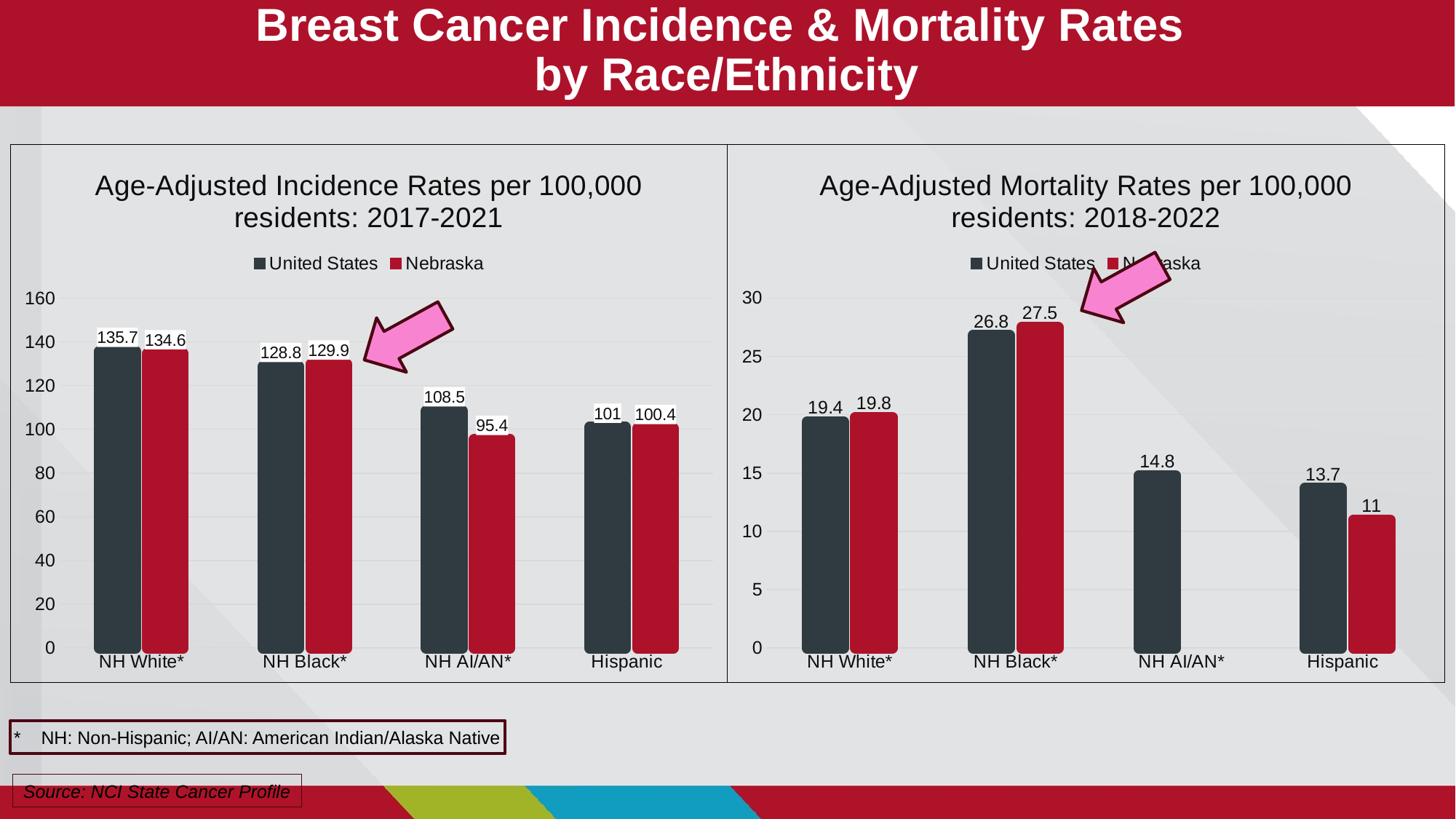
In the mortality rates chart on the right, which category has the lowest Nebraska value? Hispanic What kind of chart is the incidence rates chart on the left? Bar chart How many series does the legend of the mortality rates chart on the right list? 2 In the incidence rates chart on the left, which category has the highest Nebraska value? NH White* In the mortality rates chart on the right, what is the United States value for Hispanic? 13.7 In the mortality rates chart on the right, what is the difference between the United States and Nebraska values for Hispanic? 2.7 In the incidence rates chart on the left, what is the United States value for NH White*? 135.7 In the mortality rates chart on the right, which is larger for NH Black*: the United States value or the Nebraska value? Nebraska In the incidence rates chart on the left, is the Nebraska value for Hispanic greater or less than 120? less In the mortality rates chart on the right, what is the Nebraska value for NH Black*? 27.5 In the incidence rates chart on the left, what is the Nebraska value for NH AI/AN*? 95.4 In the incidence rates chart on the left, what is the difference between the United States and Nebraska values for NH AI/AN*? 13.1